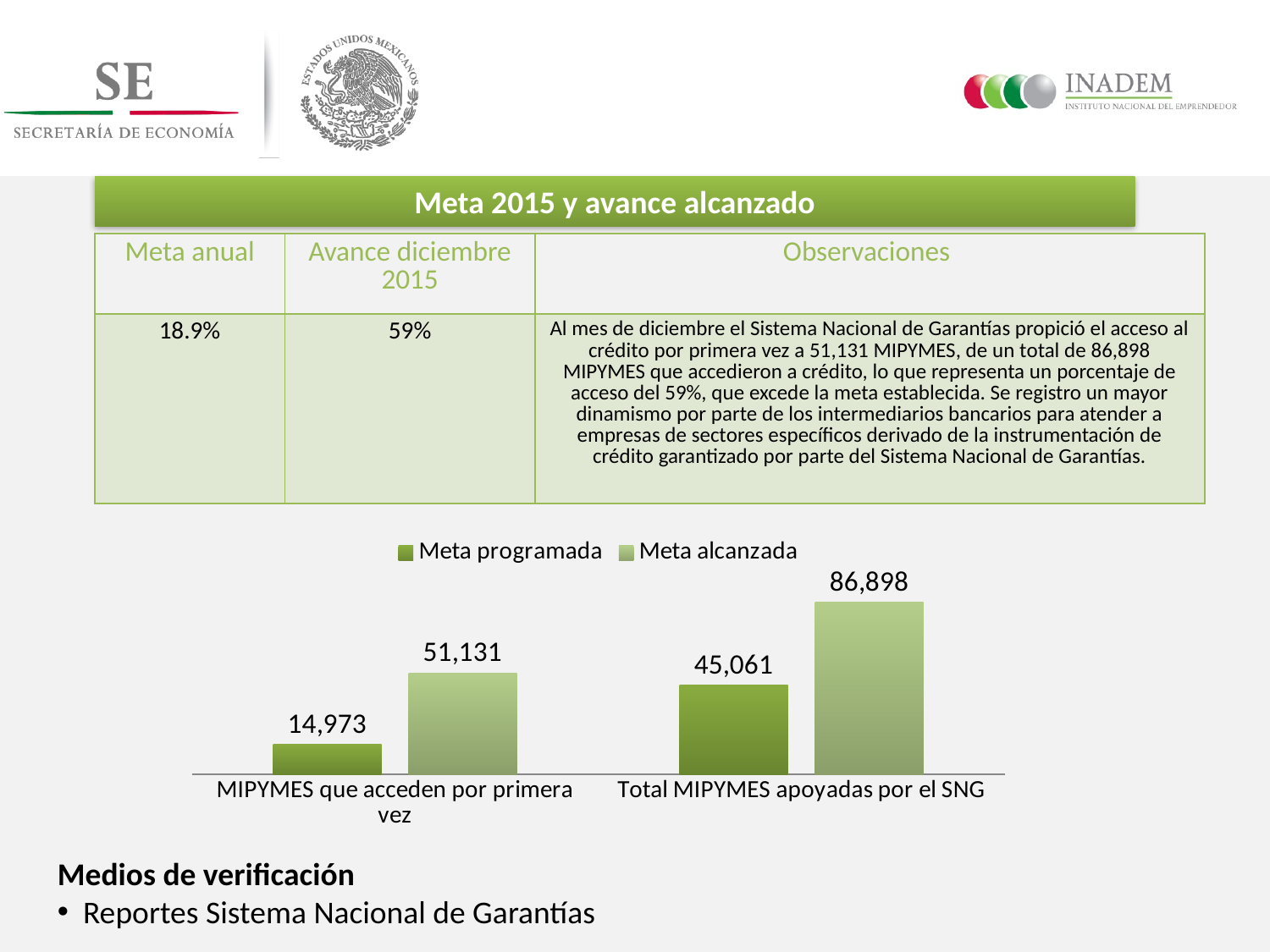
What is the difference between Meta alcanzada and Meta programada for MIPYMES que acceden por primera vez? 36,158 What is the value of Meta alcanzada for MIPYMES que acceden por primera vez? 51,131 What kind of chart is shown on the slide? Bar chart Which is larger: Meta alcanzada for MIPYMES que acceden por primera vez or Meta programada for Total MIPYMES apoyadas por el SNG? Meta alcanzada for MIPYMES que acceden por primera vez Which bar in the chart has the highest value? Meta alcanzada for Total MIPYMES apoyadas por el SNG How many categories are shown on the x axis of the chart? 2 How many series does the chart legend list? 2 What is the value of Meta alcanzada for Total MIPYMES apoyadas por el SNG? 86,898 Which bar in the chart has the lowest value? Meta programada for MIPYMES que acceden por primera vez What is the value of Meta programada for Total MIPYMES apoyadas por el SNG? 45,061 What is the value of Meta programada for MIPYMES que acceden por primera vez? 14,973 What is the difference between Meta alcanzada and Meta programada for Total MIPYMES apoyadas por el SNG? 41,837